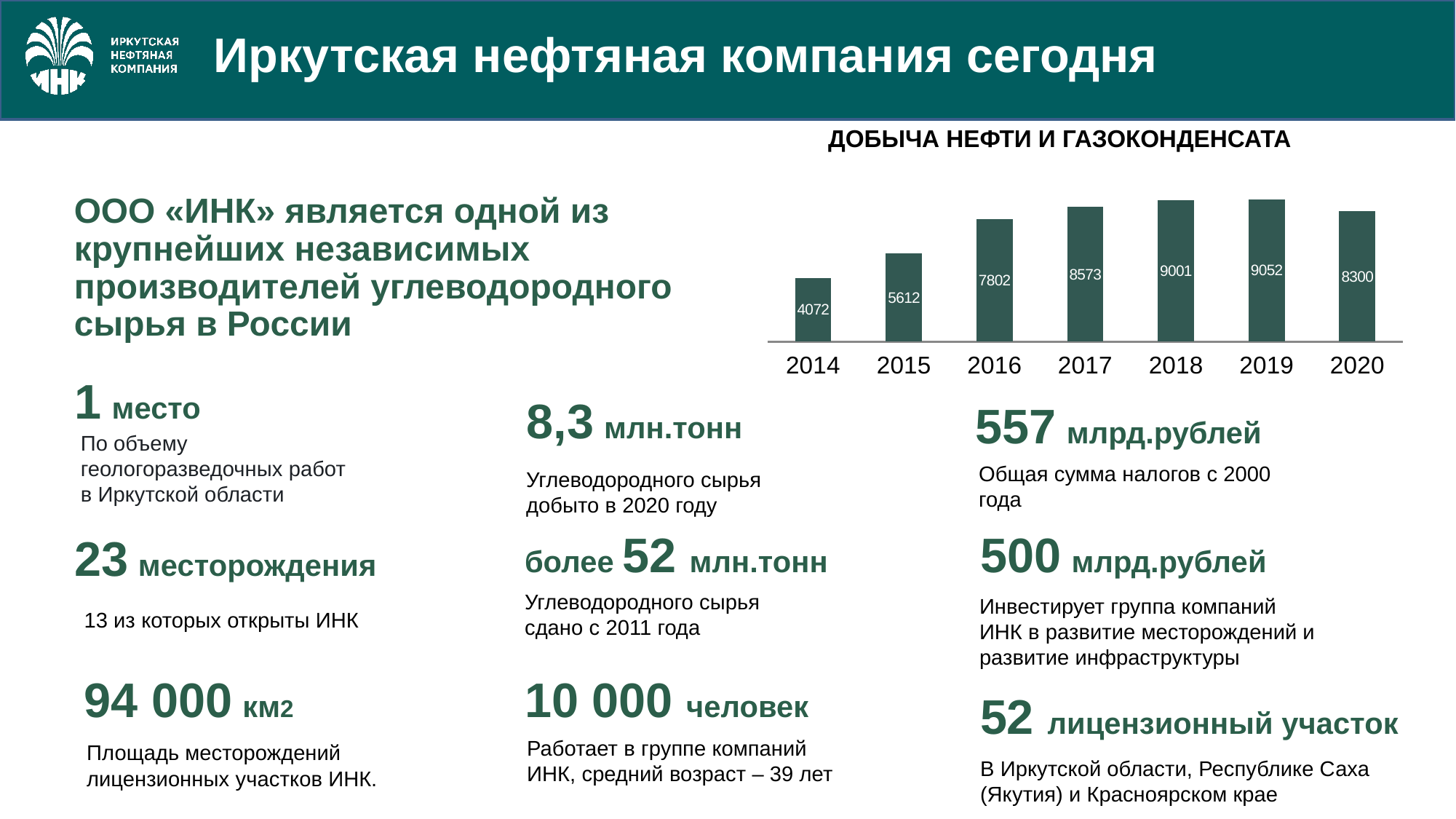
What is the difference between the values for 2015 and 2014? 1540 How many years are shown on the x axis of the chart? 7 Do the values rise or fall from 2014 to 2019? rise What is the difference between the values for 2019 and 2020? 752 What is the value for 2014 in the chart? 4072 Which is larger, the value for 2016 or the value for 2018? 2018 What is the value for 2020 in the chart? 8300 Which year has the lowest value in the chart? 2014 What is the title of the chart? ДОБЫЧА НЕФТИ И ГАЗОКОНДЕНСАТА What kind of chart is shown on the slide? bar chart Which year has the highest value in the chart? 2019 What is the value for 2017 in the chart? 8573